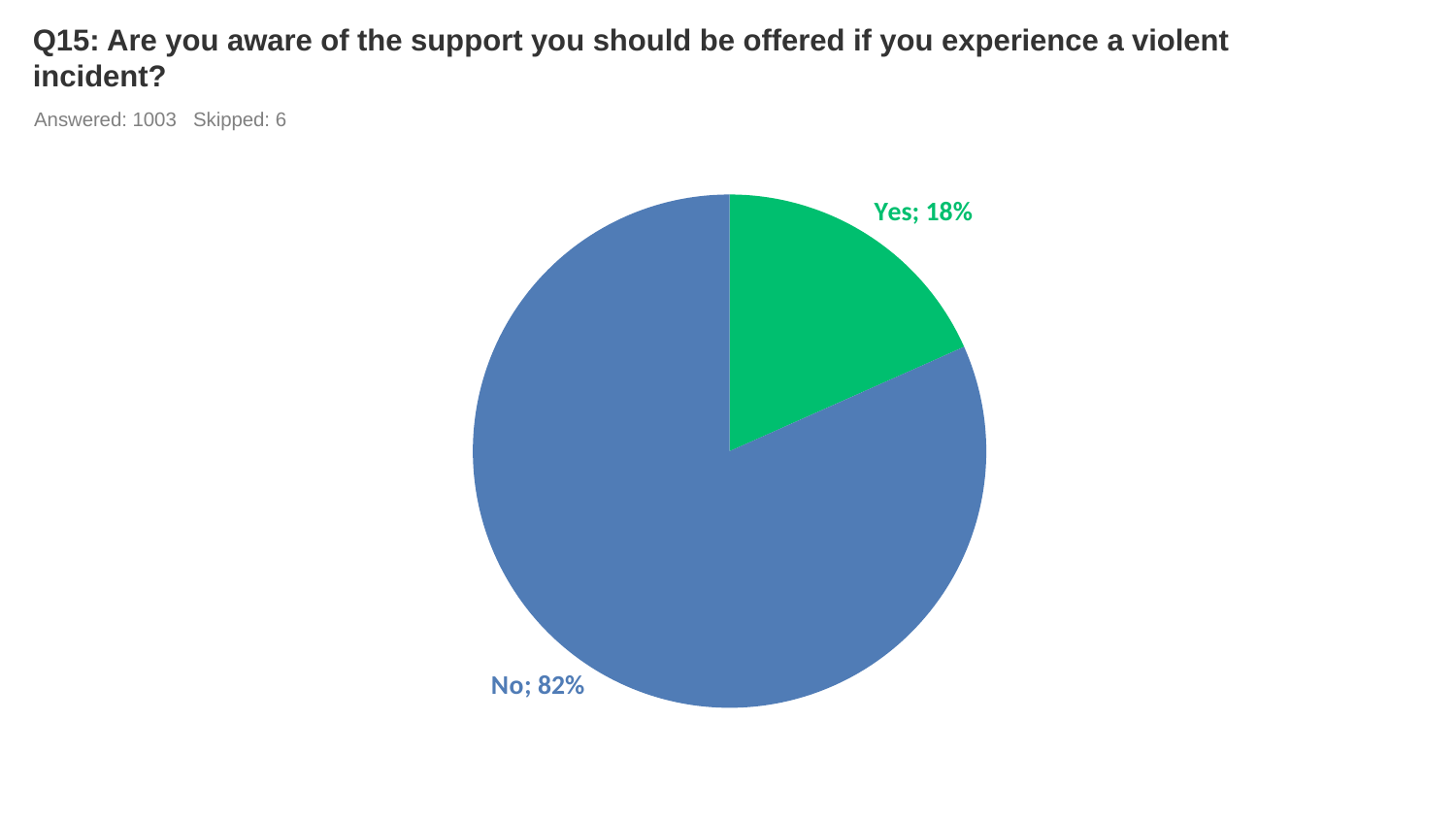
How many people answered this question according to the slide? 1003 What percentage of respondents answered "No"? 82% Which is larger, the "Yes" slice or the "No" slice? No What is the difference in percentage points between the "No" and "Yes" slices? 64 What kind of chart is shown on the slide? Pie chart What share of the pie does the "No" slice represent? 82% What percentage of respondents answered "Yes"? 18% Which response has the largest share of the pie? No What colour is the "Yes" slice? Green How many slices does the pie chart have? 2 Which response has the smallest share of the pie? Yes